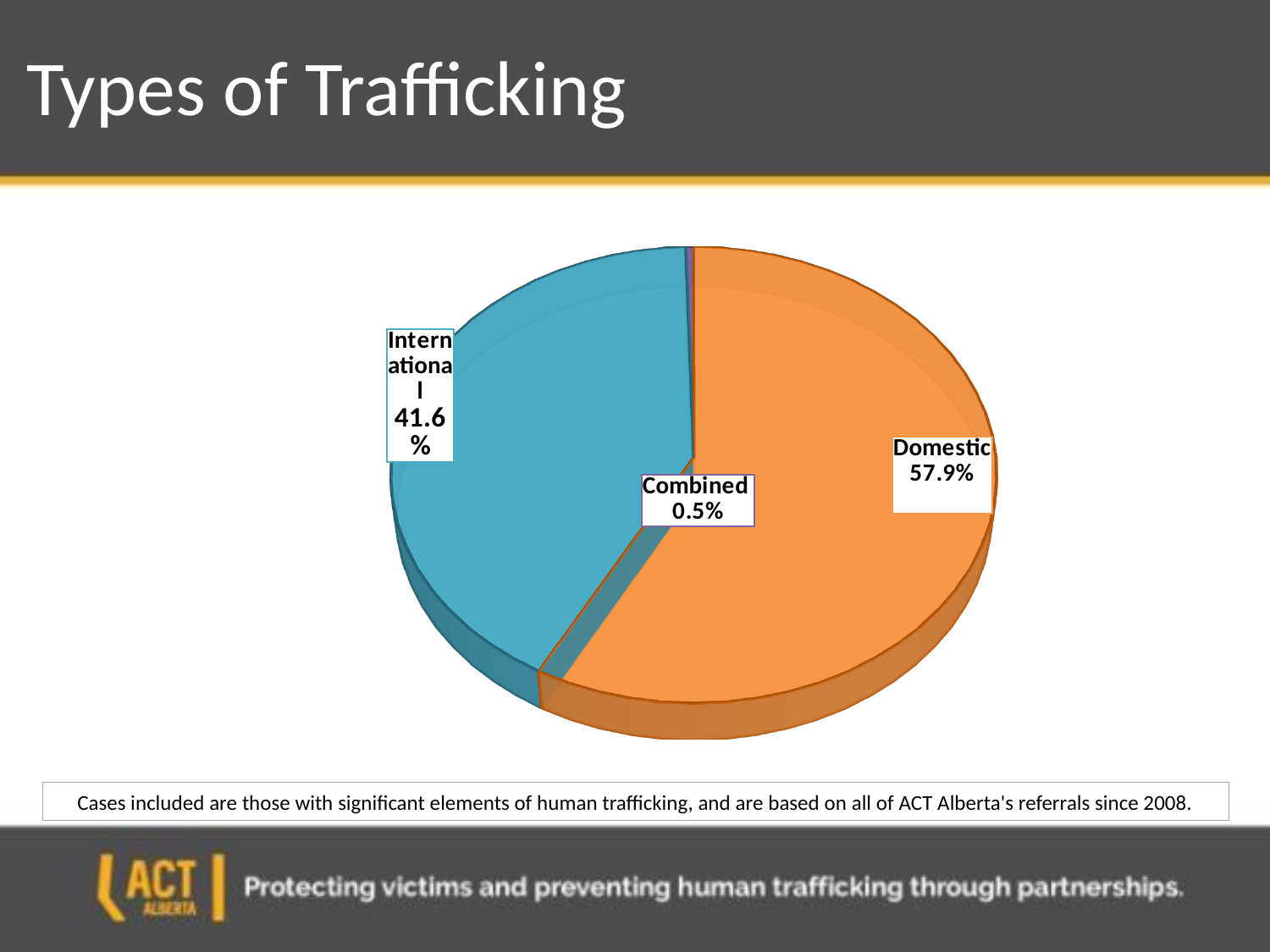
What share of the pie does Combined trafficking represent? 0.5% What is the title of the slide containing the pie chart? Types of Trafficking What colour is the Domestic slice of the pie chart? orange Which type of trafficking has the largest share of the pie? Domestic What kind of chart is shown on the slide? pie chart Which type of trafficking has the smallest share of the pie? Combined Which is larger, the International share or the Domestic share? Domestic How many slices does the pie chart have? 3 What share of the pie does Domestic trafficking represent? 57.9% What is the difference in percentage points between the International and Combined shares? 41.1 What share of the pie does International trafficking represent? 41.6% What is the difference in percentage points between the Domestic and International shares? 16.3